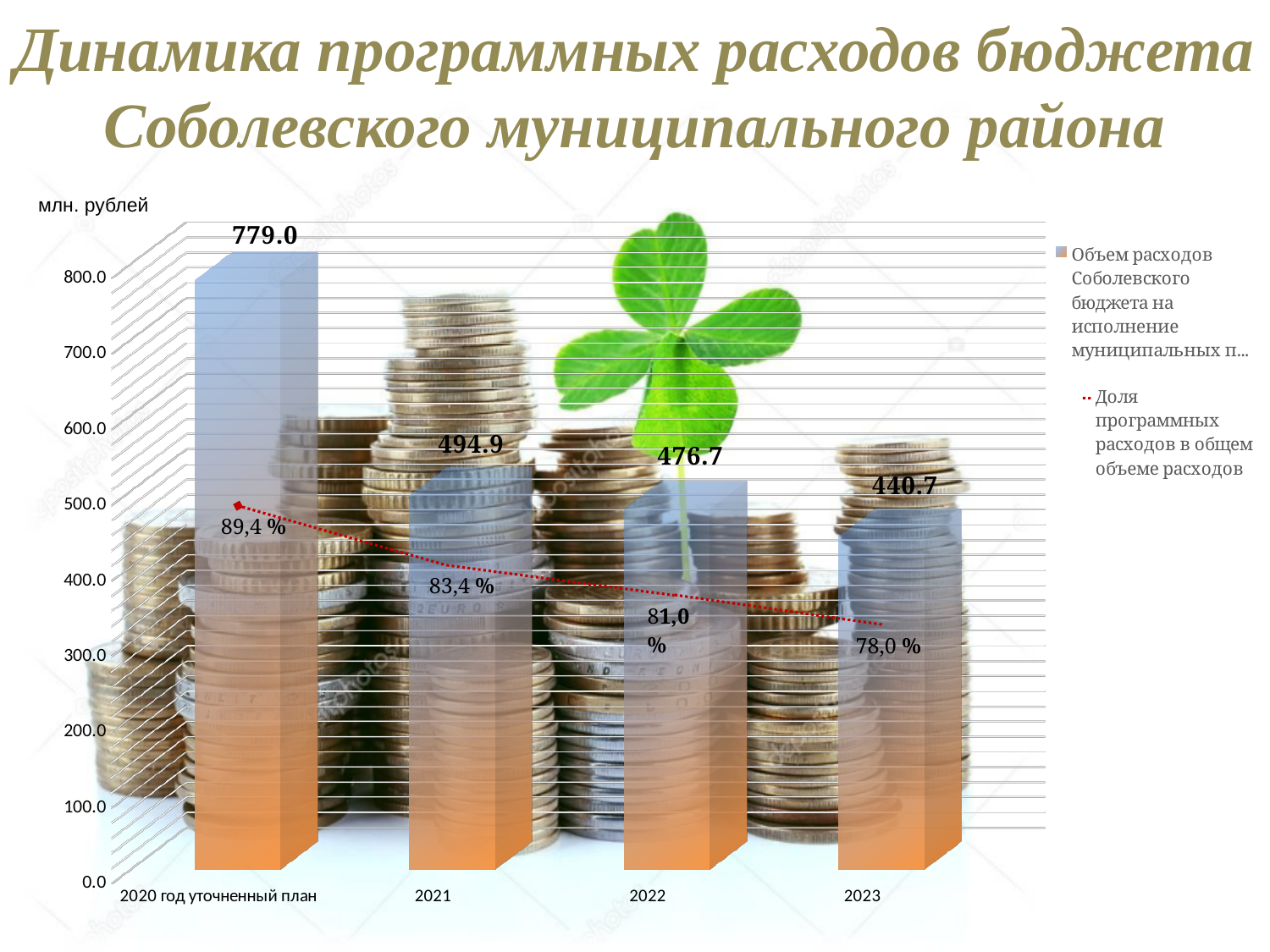
What is the value of the bar for 2023? 440.7 Which is larger, the bar value for 2022 or for 2023? 2022 What is the value of the bar for 2021? 494.9 How many series does the legend list? 2 What share of programme expenditures (Доля программных расходов) is shown for 2022? 81,0 % Which category has the highest bar value? 2020 год уточненный план Do the share values (Доля программных расходов) rise or fall from 2020 to 2023? fall How many categories are shown on the x axis? 4 What is the value of the bar for '2020 год уточненный план'? 779.0 What share of programme expenditures (Доля программных расходов) is shown for 2023? 78,0 % Which category has the lowest bar value? 2023 What is the difference between the bar values for 2021 and 2022? 18.2